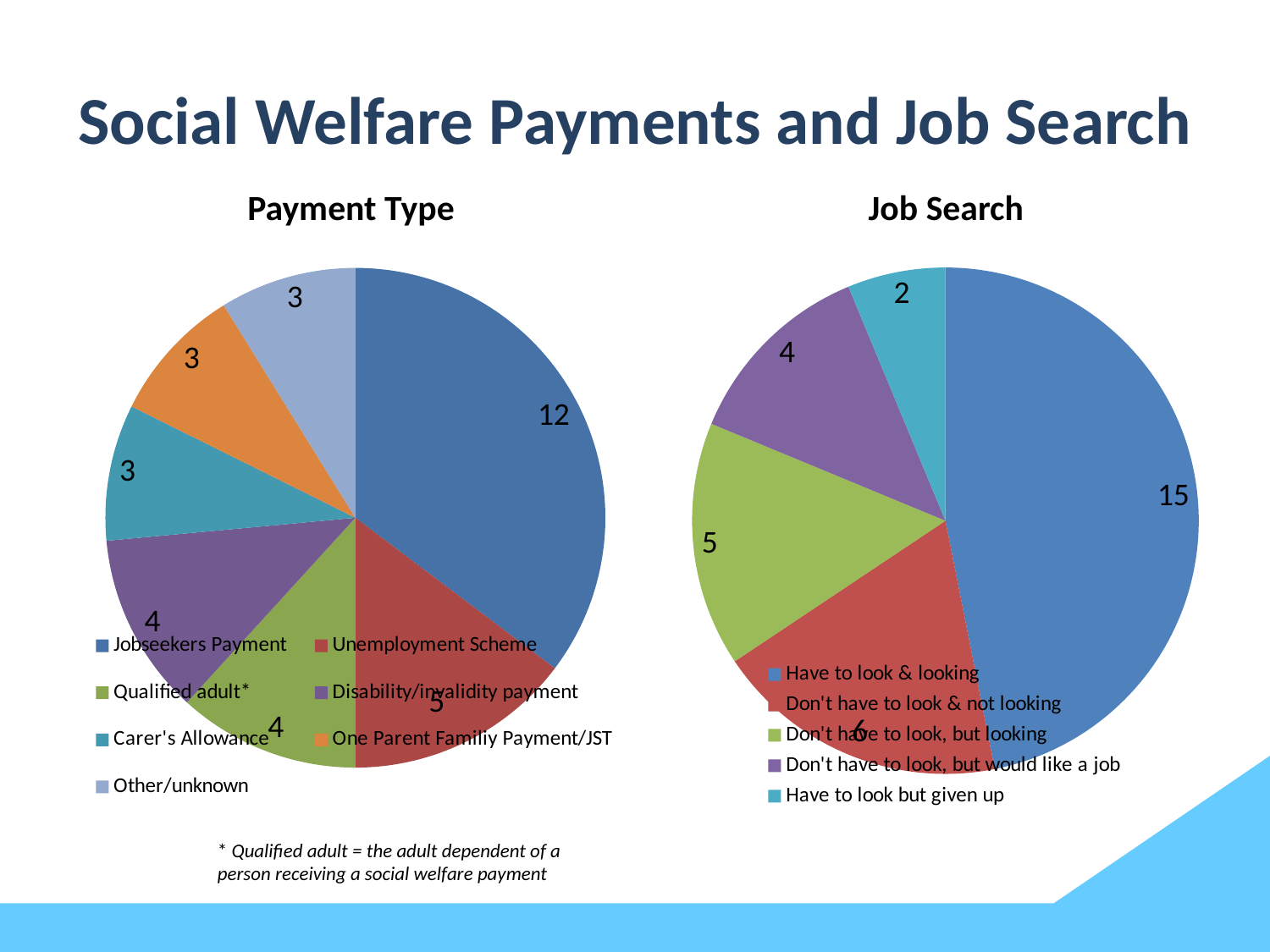
In the Job Search chart, which category has the smallest slice? Have to look but given up In the Job Search chart, which is larger: Don't have to look & not looking or Don't have to look, but looking? Don't have to look & not looking In the Job Search chart, what is the value for Have to look & looking? 15 How many categories does the Job Search chart's legend list? 5 In the Payment Type chart, what is the value for Unemployment Scheme? 5 In the Payment Type chart, what is the value for Jobseekers Payment? 12 In the Payment Type chart, which category has the largest slice? Jobseekers Payment In the Payment Type chart, what is the difference between Jobseekers Payment and Unemployment Scheme? 7 What is the title of the chart on the right of the slide? Job Search How many categories does the Payment Type chart's legend list? 7 What kind of chart is the Payment Type chart? pie chart In the Job Search chart, what is the value for Have to look but given up? 2